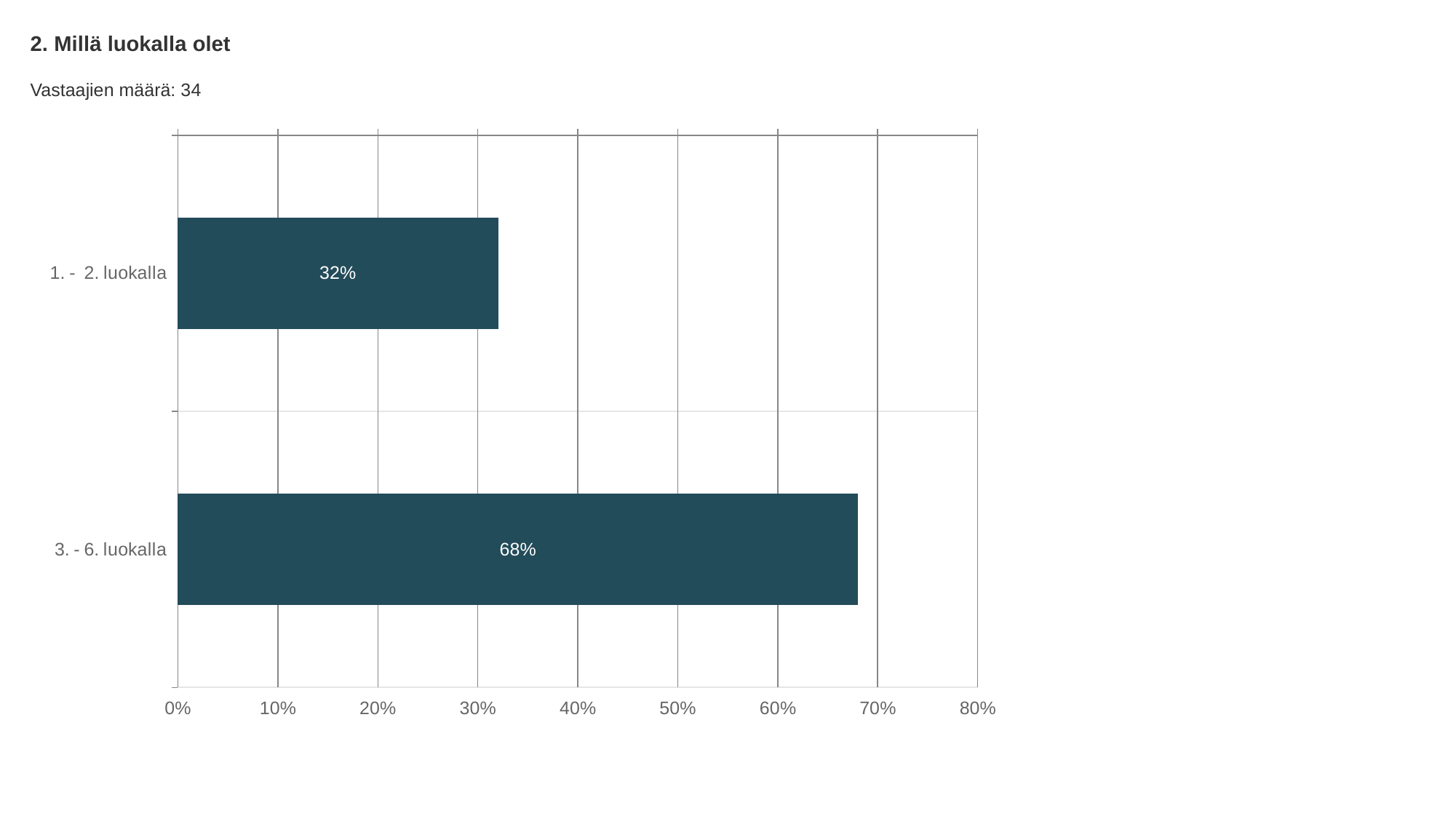
Is the value for "3. - 6. luokalla" greater or less than 50%? greater How many categories are shown in the chart? 2 What is the value for "3. - 6. luokalla"? 68% What kind of chart is shown on the slide? bar chart What is the difference between the values for "3. - 6. luokalla" and "1. - 2. luokalla"? 36% What is the value for "1. - 2. luokalla"? 32% Which category has the highest value? 3. - 6. luokalla Which category has the lowest value? 1. - 2. luokalla Is the value for "1. - 2. luokalla" greater or less than 40%? less How many respondents (Vastaajien määrä) are reported on the slide? 34 What is the title of the chart? 2. Millä luokalla olet Which is larger, the value for "1. - 2. luokalla" or the value for "3. - 6. luokalla"? 3. - 6. luokalla